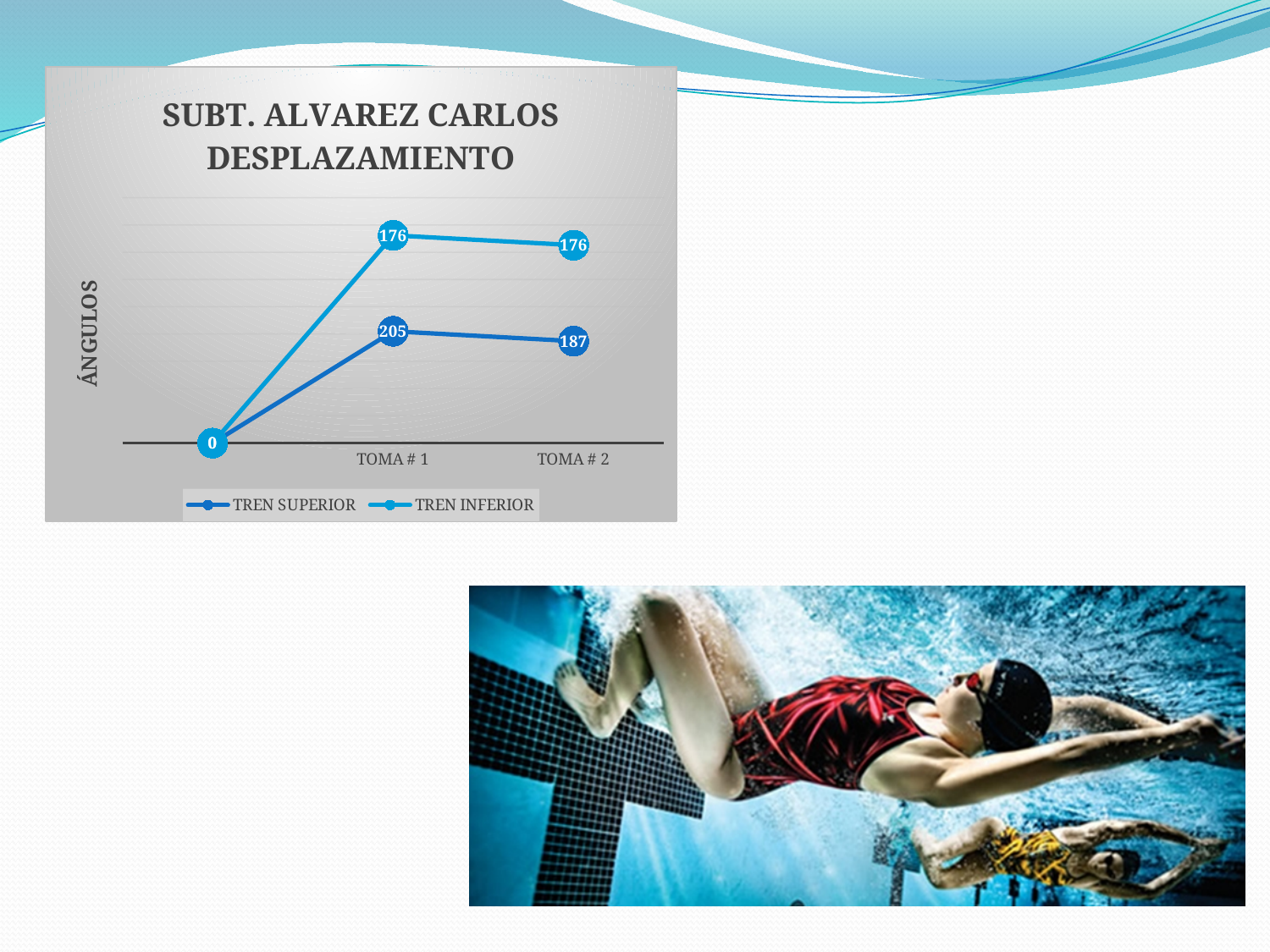
What is the difference between the TREN SUPERIOR and TREN INFERIOR values at TOMA # 2? 11 What kind of chart is shown on the slide? line chart What is the label of the vertical axis? ÁNGULOS What is the value of TREN SUPERIOR at TOMA # 2? 187 Does the TREN INFERIOR value change between TOMA # 1 and TOMA # 2? No, it stays at 176 How many series does the legend list? 2 Does the TREN SUPERIOR value rise or fall from TOMA # 1 to TOMA # 2? fall What is the title of the chart? SUBT. ALVAREZ CARLOS DESPLAZAMIENTO What is the difference between the TREN SUPERIOR values at TOMA # 1 and TOMA # 2? 18 What is the value of TREN SUPERIOR at TOMA # 1? 205 What is the value of TREN INFERIOR at TOMA # 2? 176 What is the value of TREN INFERIOR at TOMA # 1? 176